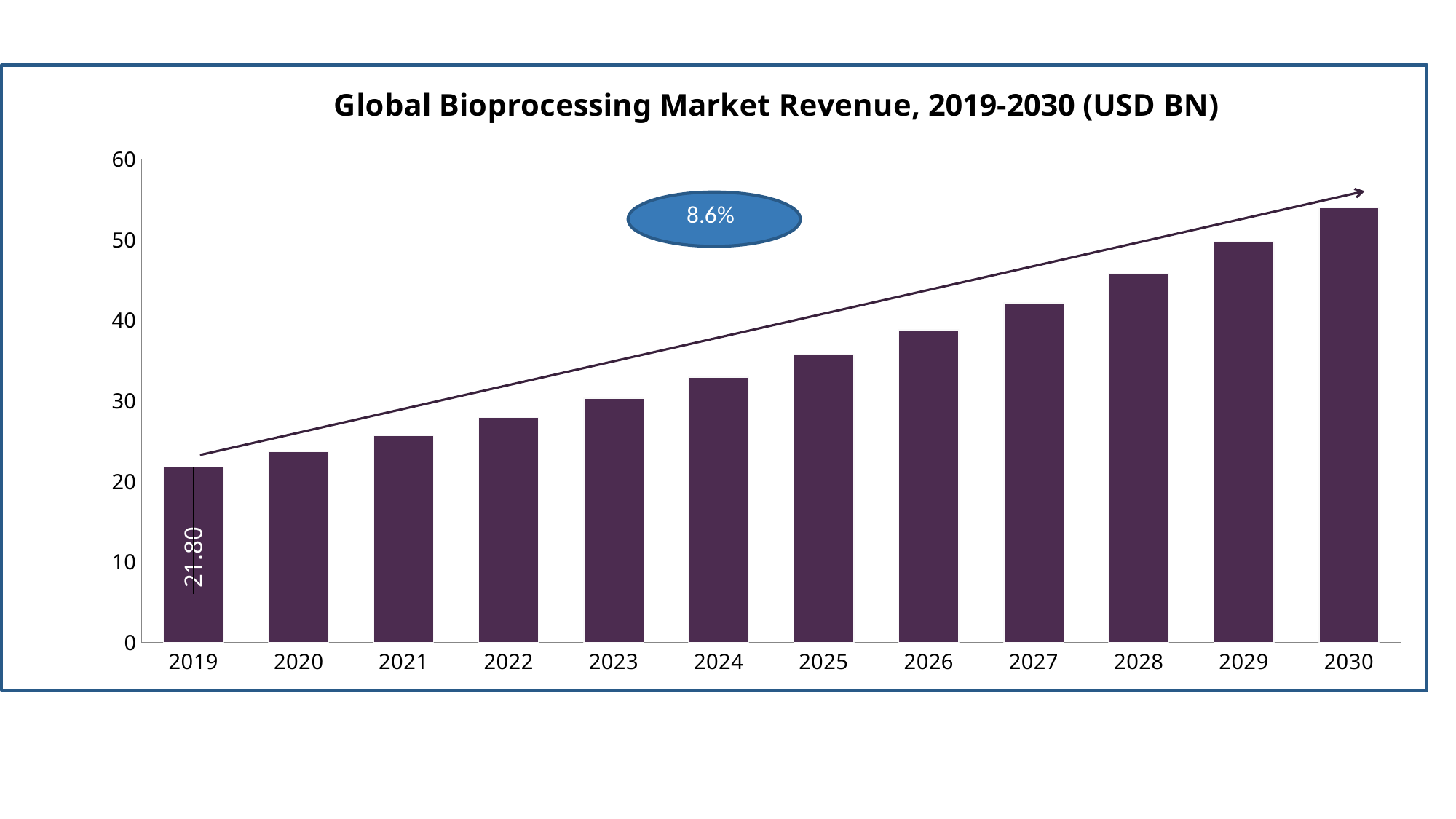
How many years are shown on the x axis? 12 Which year has the lowest value? 2019 What type of chart is shown on the slide? bar chart Is the value for 2021 greater or less than 30? less Which year has the highest value? 2030 Do the values rise or fall from 2019 to 2030? rise Is the value for 2024 greater or less than 30? greater What is the value for 2019? 21.80 What is the title of the chart? Global Bioprocessing Market Revenue, 2019-2030 (USD BN) What percentage is shown in the blue oval on the chart? 8.6% Which is larger, the value for 2027 or the value for 2023? 2027 Is the value for 2030 greater or less than 50? greater